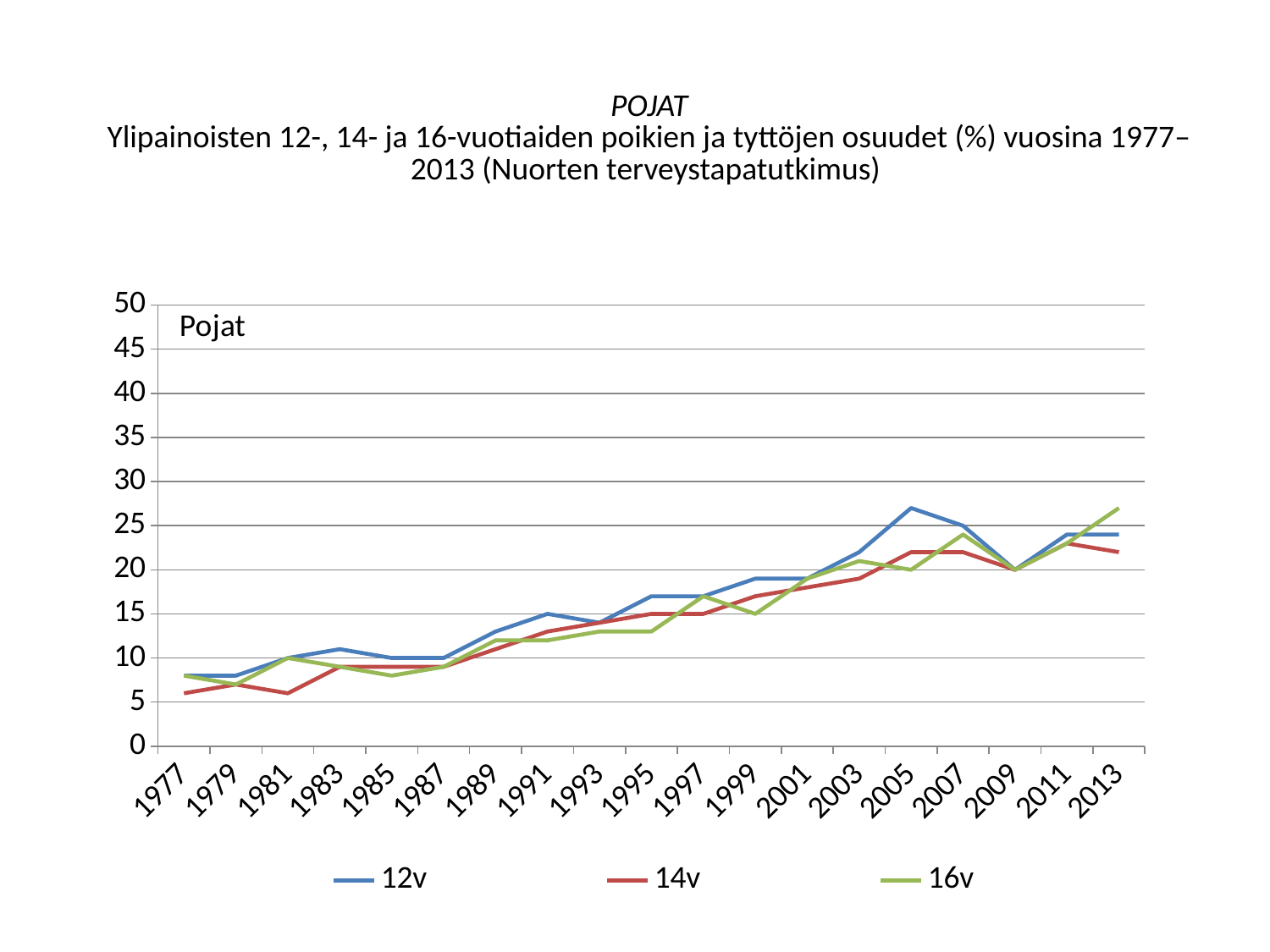
In 2013, which series has the higher value, 14v or 16v? 16v What colour is the line for the 16v series? green Is the value for 16v in 2013 greater or less than 25? greater Overall, do the values for the 12v series rise or fall from 1977 to 2013? rise What kind of chart is shown on the slide? line chart How many series does the legend list? 3 In 1977, which series has the higher value, 12v or 14v? 12v Is the value for 12v in 2005 greater or less than 25? greater Is the value for 14v in 1985 greater or less than 10? less How many years are marked along the x axis? 19 In which year does the 12v series reach its highest value? 2005